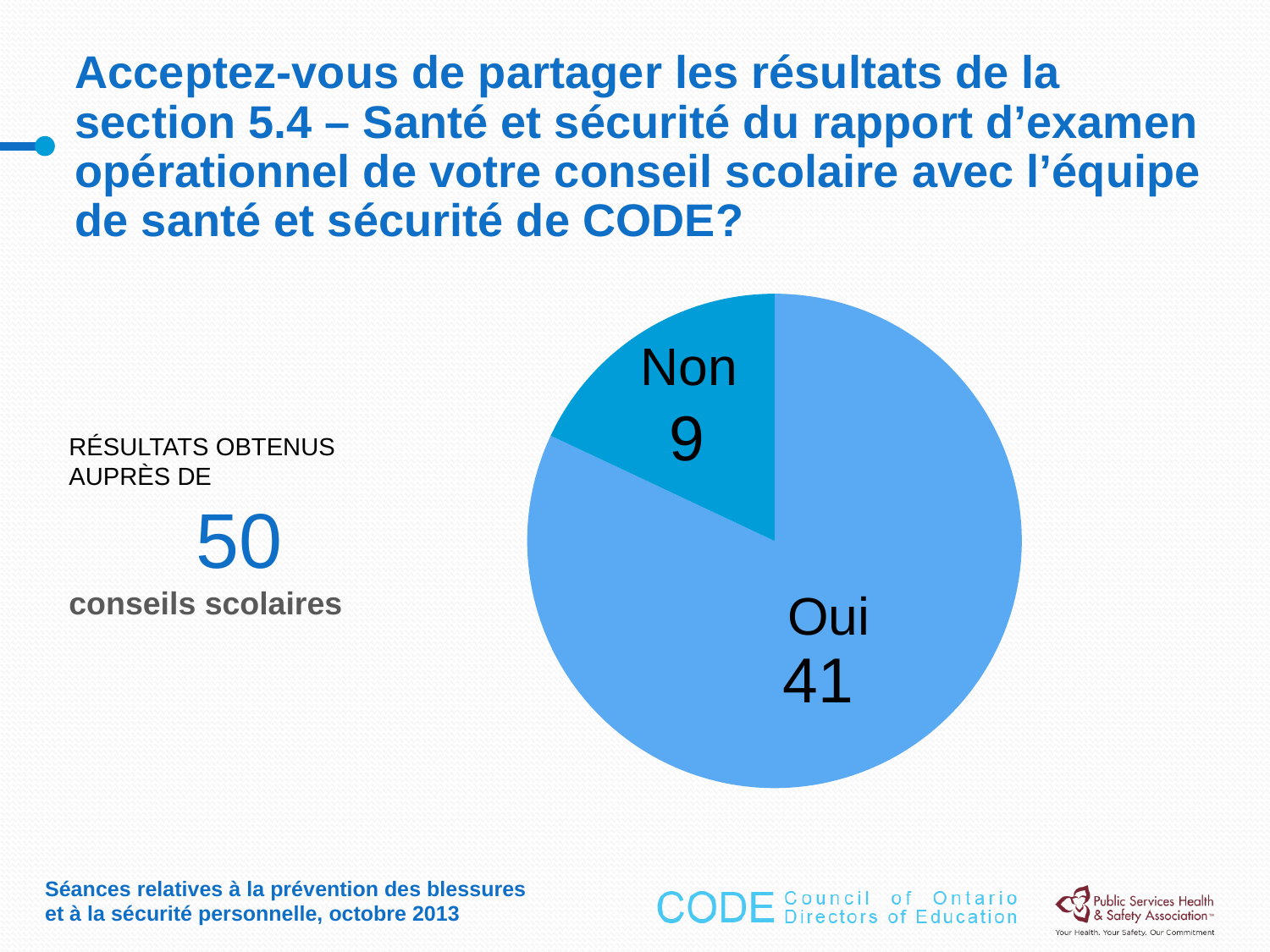
Which response has the smallest slice of the pie? Non What share of the pie does the "Oui" slice represent? 82% How many school boards answered "Oui"? 41 How many school boards answered "Non"? 9 What is the difference between the number of "Oui" and "Non" responses? 32 What kind of chart is shown on the slide? pie chart How many school boards does the slide say the results were obtained from? 50 How many slices does the pie chart have? 2 What is the total of the two slices in the pie chart? 50 What share of the pie does the "Non" slice represent? 18% Which response has the largest slice of the pie? Oui Which is larger, the "Oui" slice or the "Non" slice? Oui